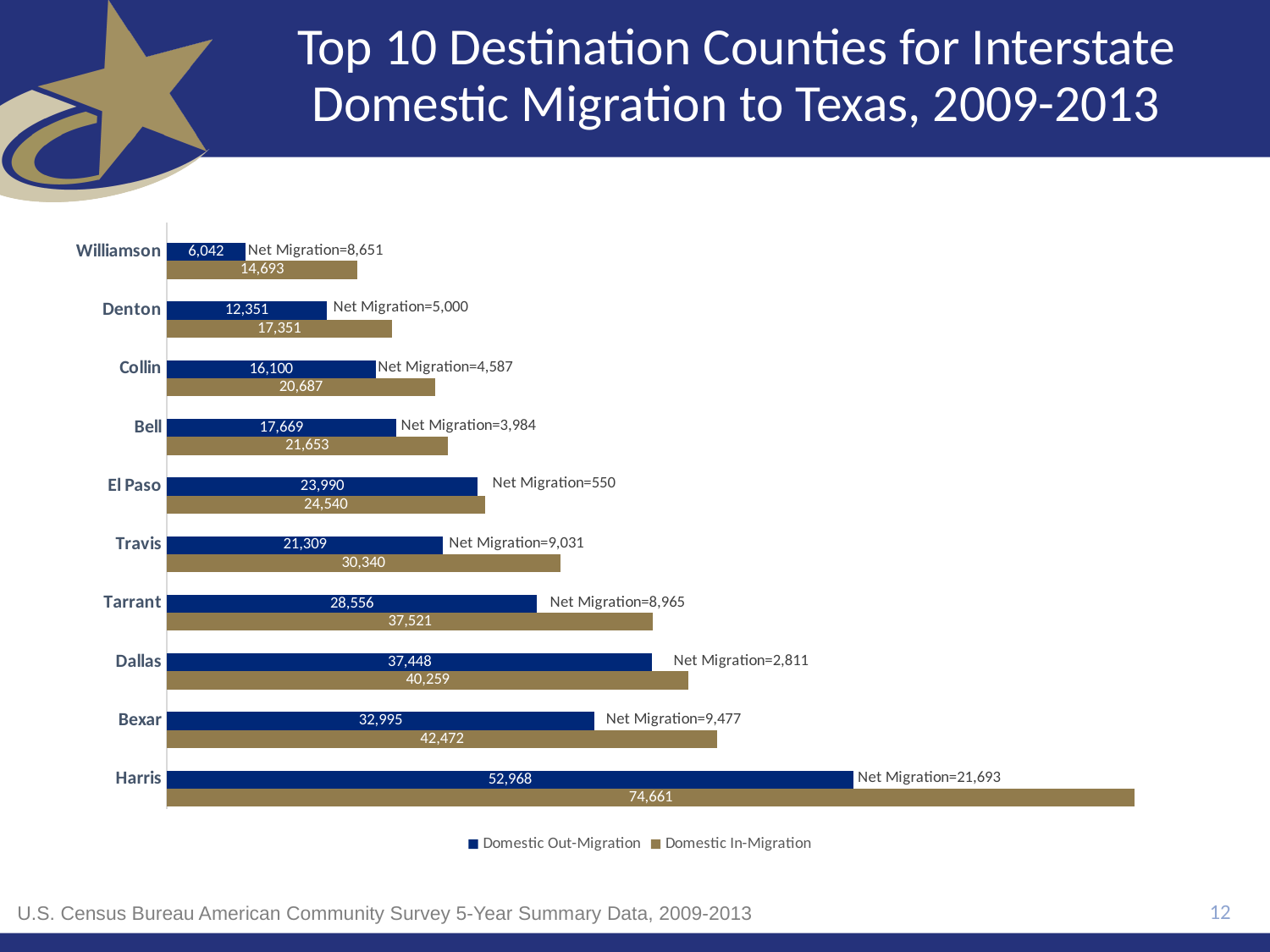
How many series does the legend list? 2 What net migration figure is shown for Bexar? 9,477 What is the Domestic In-Migration value for Harris? 74,661 How many counties are shown in the chart? 10 What is the Domestic In-Migration value for Williamson? 14,693 Which is larger, the Domestic Out-Migration for Dallas or for Bexar? Dallas What is the difference between Domestic In-Migration and Domestic Out-Migration for Dallas? 2,811 Which series is shown in gold in the chart? Domestic In-Migration Which county has the highest Domestic In-Migration? Harris Which county has the lowest Domestic Out-Migration? Williamson What kind of chart is shown on the slide? Bar chart What is the Domestic Out-Migration value for Travis? 21,309